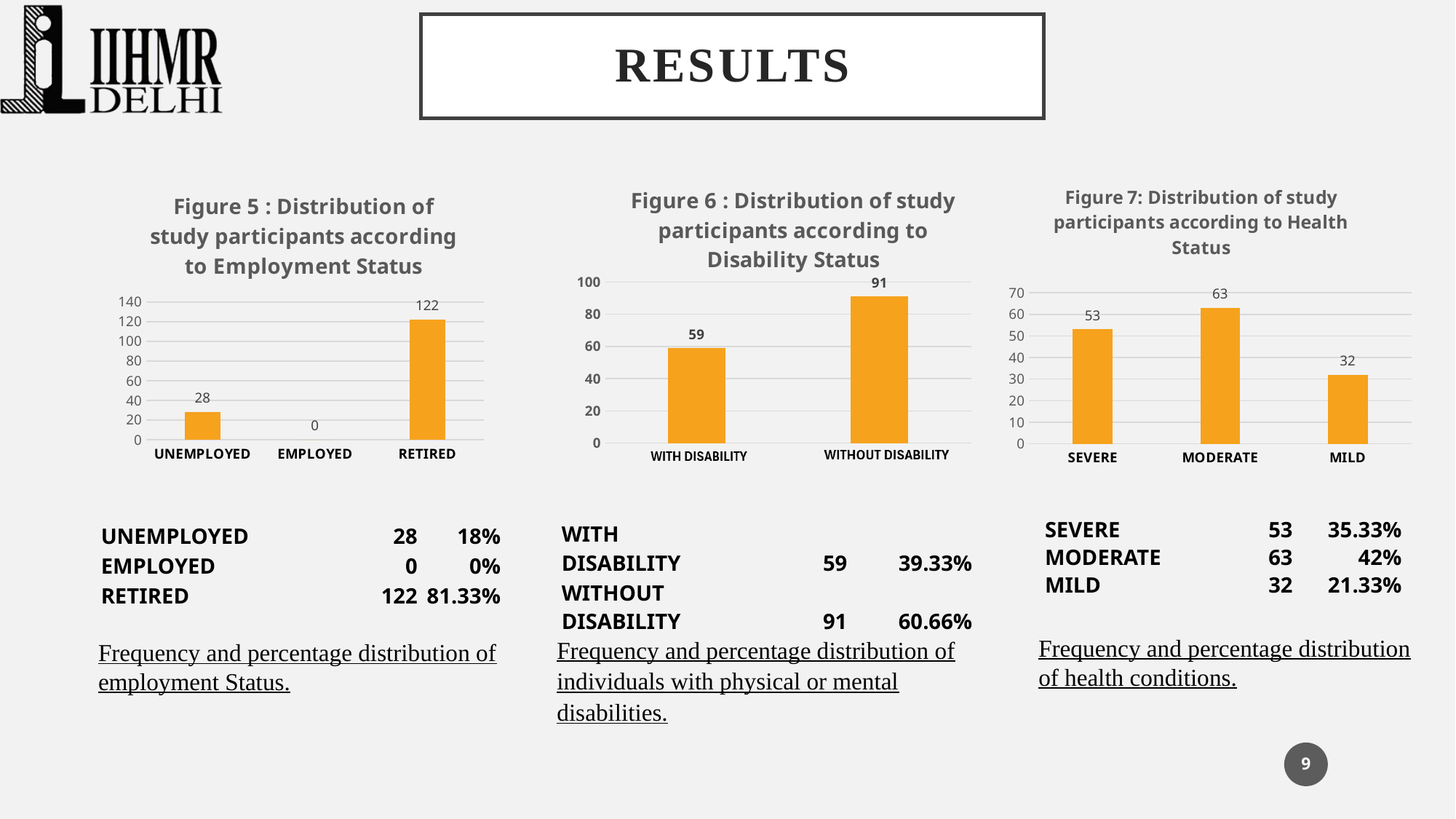
What kind of chart is Figure 6 (Disability Status)? bar chart In Figure 6 (Disability Status), which category has the highest value? WITHOUT DISABILITY In Figure 5 (Employment Status), which category has the lowest value? EMPLOYED In Figure 5 (Employment Status), what is the value for RETIRED? 122 In Figure 5 (Employment Status), what is the difference between RETIRED and UNEMPLOYED? 94 In Figure 7 (Health Status), which category has the highest value? MODERATE In Figure 7 (Health Status), what is the difference between MODERATE and SEVERE? 10 In Figure 7 (Health Status), is the value for SEVERE larger or smaller than the value for MILD? larger In Figure 5 (Employment Status), how many categories are shown on the x axis? 3 In Figure 6 (Disability Status), what is the difference between WITHOUT DISABILITY and WITH DISABILITY? 32 In Figure 7 (Health Status), what is the value for MILD? 32 In Figure 6 (Disability Status), what is the value for WITH DISABILITY? 59